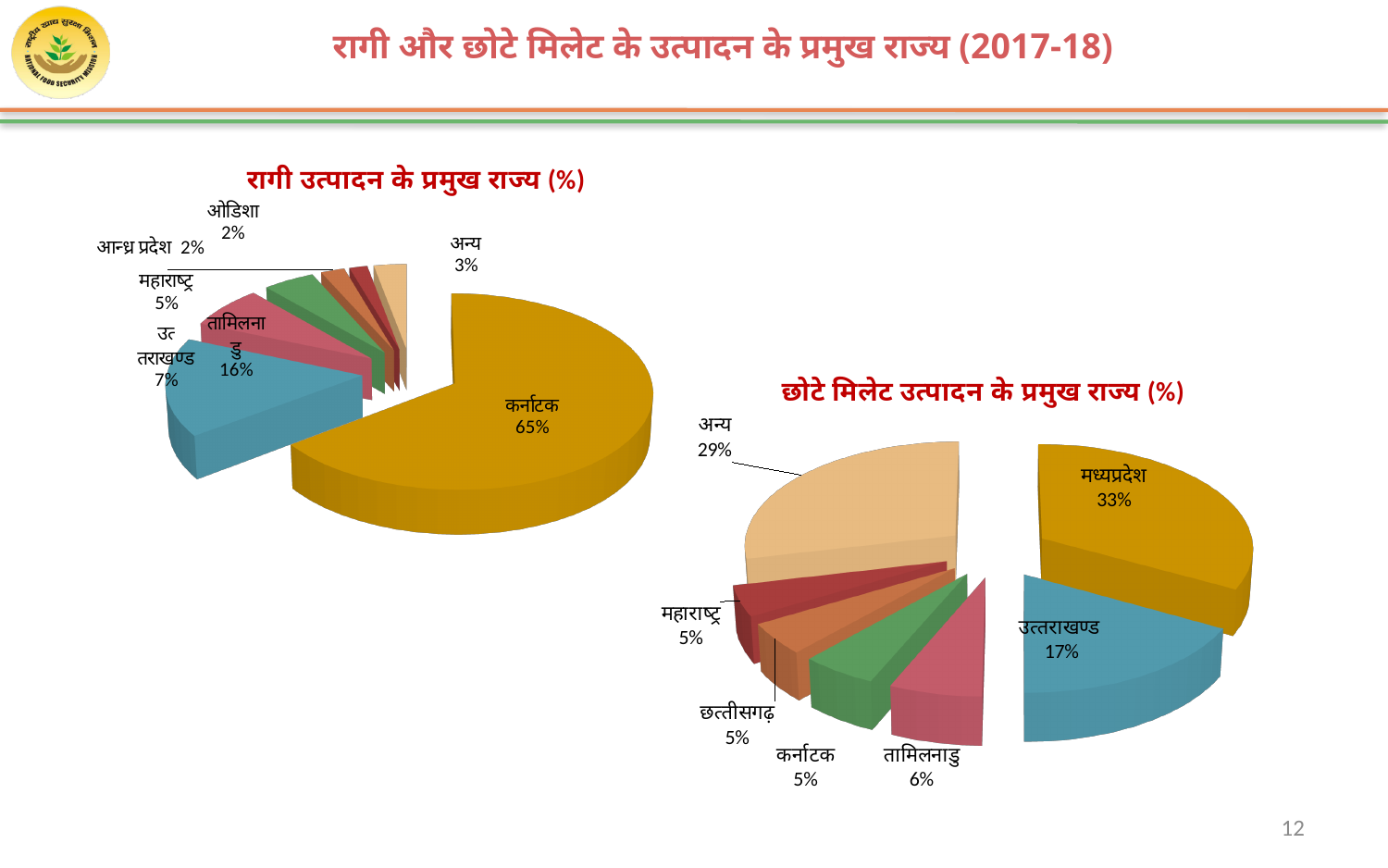
What type of chart is used on this slide? Pie chart In the right pie chart (छोटे मिलेट उत्पादन के प्रमुख राज्य), which is larger: the share of उत्तराखण्ड or तामिलनाडु? उत्तराखण्ड In the left pie chart (रागी उत्पादन के प्रमुख राज्य), what is the share for तामिलनाडु? 16% In the left pie chart (रागी उत्पादन के प्रमुख राज्य), what is the share for कर्नाटक? 65% In the left pie chart (रागी उत्पादन के प्रमुख राज्य), what is the difference between the shares of कर्नाटक and तामिलनाडु? 49% What is the title of the right chart on the slide? छोटे मिलेट उत्पादन के प्रमुख राज्य (%) In the right pie chart (छोटे मिलेट उत्पादन के प्रमुख राज्य), what is the share for मध्यप्रदेश? 33% In the left pie chart (रागी उत्पादन के प्रमुख राज्य), which state has the largest share? कर्नाटक In the right pie chart (छोटे मिलेट उत्पादन के प्रमुख राज्य), what is the share for उत्तराखण्ड? 17% In the left pie chart (रागी उत्पादन के प्रमुख राज्य), how many slices does the pie have? 7 In the right pie chart (छोटे मिलेट उत्पादन के प्रमुख राज्य), what is the difference between the shares of मध्यप्रदेश and उत्तराखण्ड? 16% In the right pie chart (छोटे मिलेट उत्पादन के प्रमुख राज्य), what is the share for अन्य? 29%